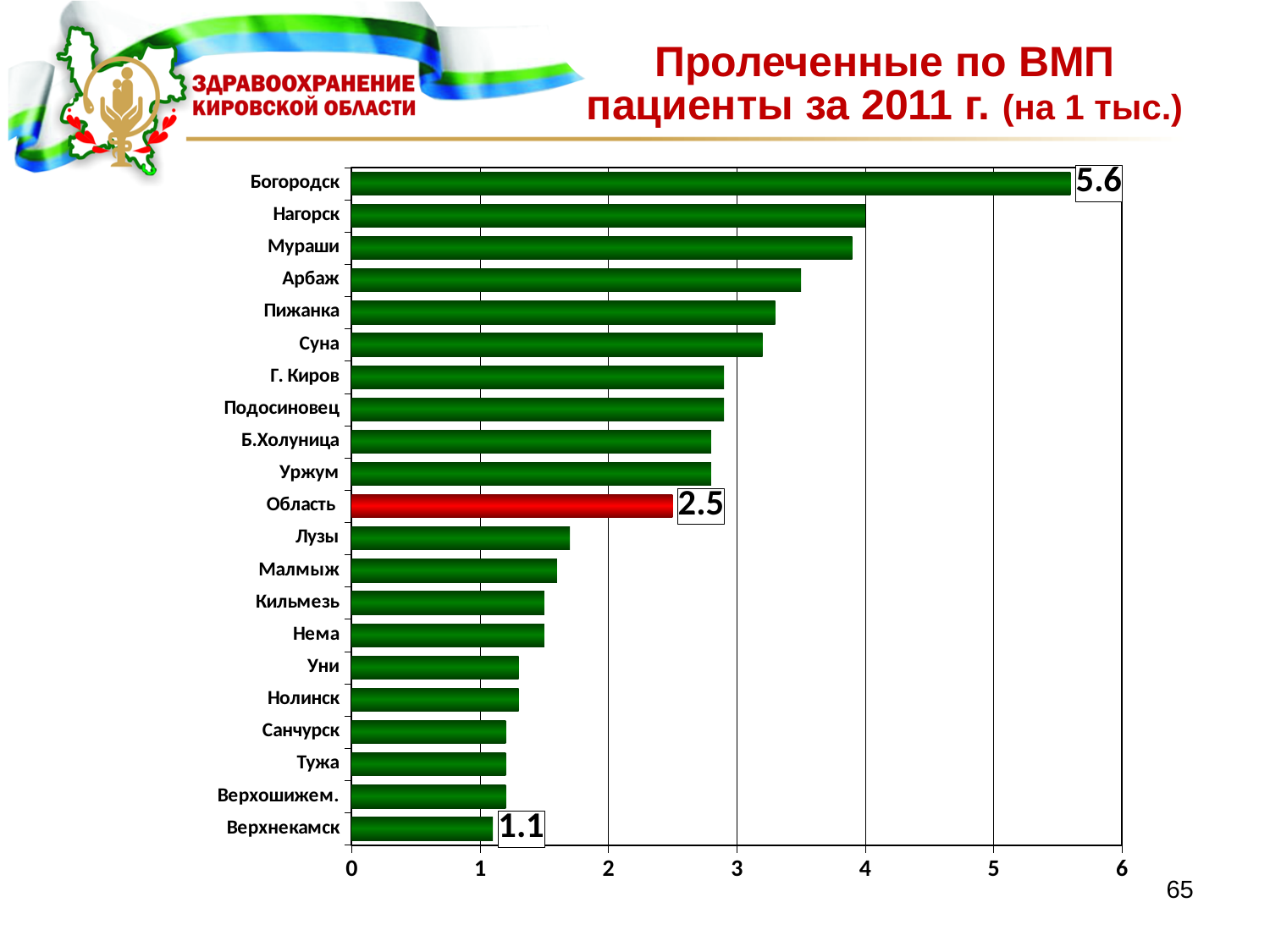
What is the value for Область? 2.5 Which category has the highest value? Богородск Is the value for Лузы greater or less than 2? less How many categories are shown on the chart? 21 What is the value for Богородск? 5.6 Which category has the lowest value? Верхнекамск What is the value for Верхнекамск? 1.1 Which is larger, the value for Мураши or the value for Арбаж? Мураши What is the difference between the values for Богородск and Область? 3.1 What is the difference between the values for Область and Верхнекамск? 1.4 What kind of chart is shown on the slide? bar chart Is the value for Суна greater or less than 3? greater